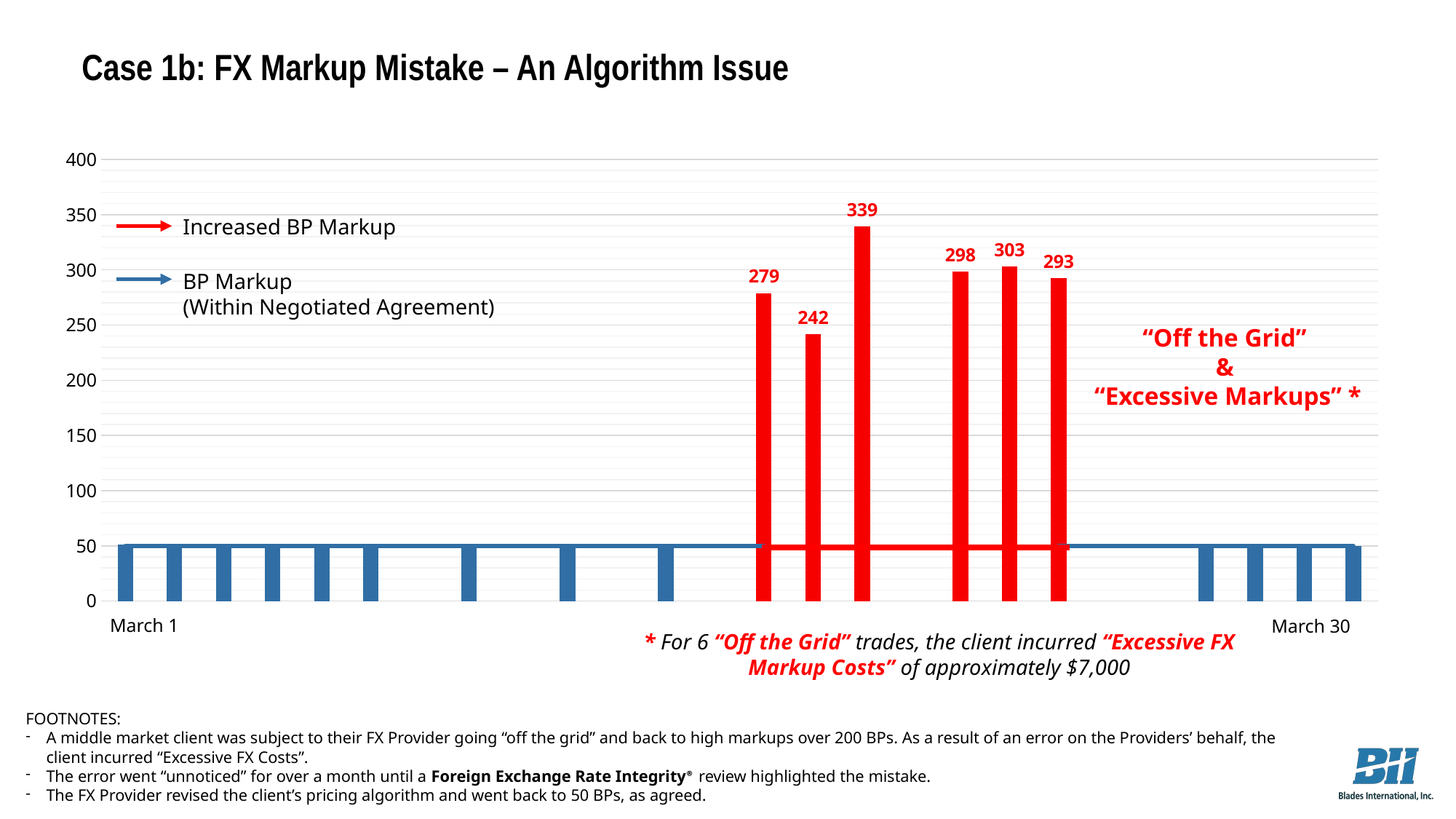
What is the value of the first (leftmost) red 'Increased BP Markup' bar? 279 What is the value of the last (rightmost) red 'Increased BP Markup' bar? 293 What is the difference between the red bars labelled 303 and 298? 5 What legend label is given to the blue bars? BP Markup (Within Negotiated Agreement) How many red 'Increased BP Markup' bars are plotted? 6 What is the highest value shown among the red 'Increased BP Markup' bars? 339 What is the lowest value shown among the labelled red 'Increased BP Markup' bars? 242 Are the blue 'BP Markup' bars greater or less than 100? less What is the difference between the highest and lowest labelled red bar values (339 and 242)? 97 Which is larger, the red bar labelled 298 or the red bar labelled 303? 303 How many series does the legend list? 2 What kind of chart is shown on the slide? Combination bar and line chart